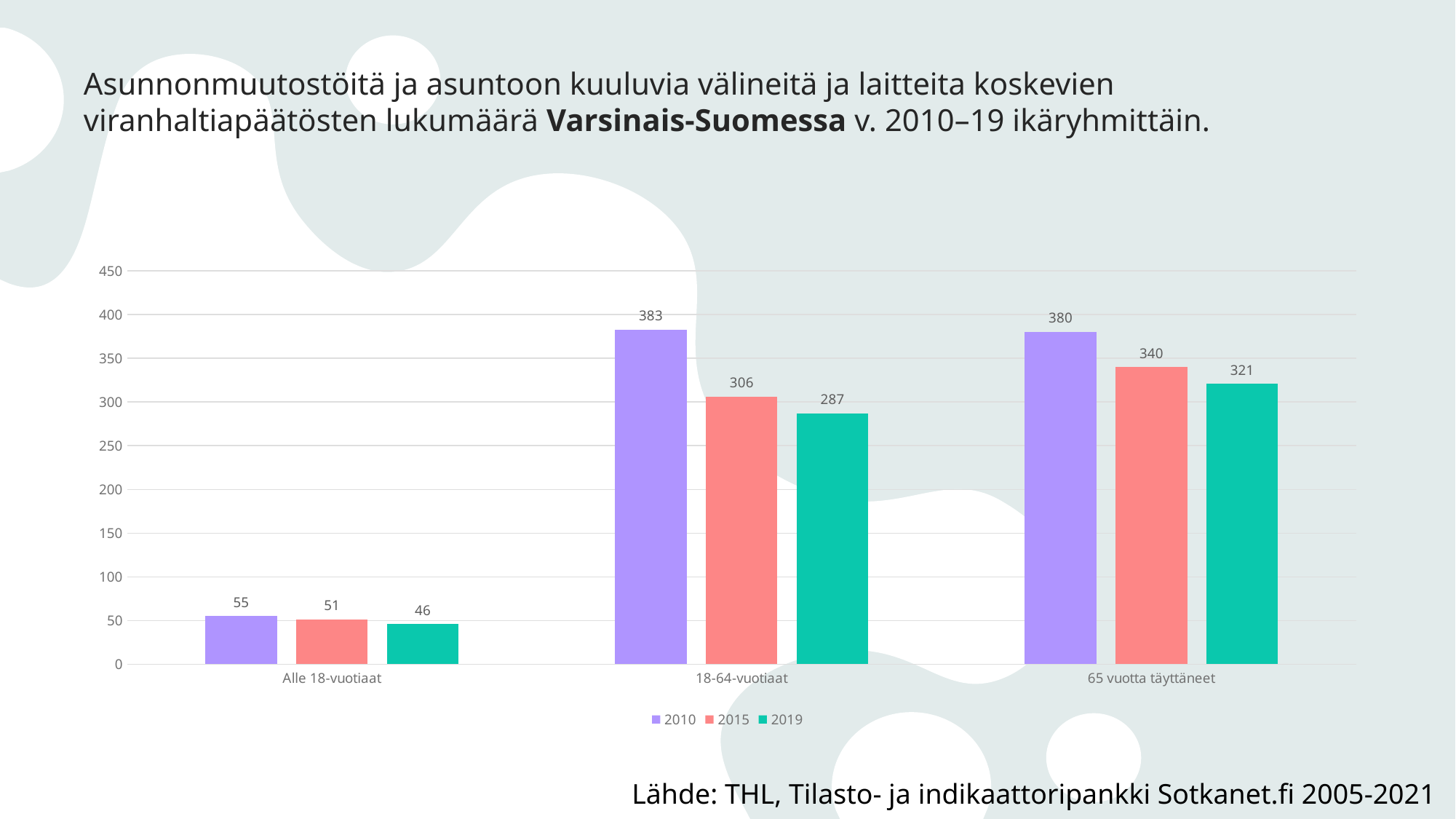
What is the value for 65 vuotta täyttäneet in 2019? 321 Is the 2019 value for 18-64-vuotiaat greater or less than 300? less What is the difference between the 2010 and 2019 values for 18-64-vuotiaat? 96 What is the value for Alle 18-vuotiaat in 2015? 51 Which age group has the lowest value in 2019? Alle 18-vuotiaat How many series does the legend list? 3 Which is larger: the 2015 value for 18-64-vuotiaat or the 2015 value for 65 vuotta täyttäneet? 65 vuotta täyttäneet What is the value for 18-64-vuotiaat in 2010? 383 Which age group has the highest value in 2015? 65 vuotta täyttäneet What kind of chart is shown on the slide? bar chart How many age groups are shown on the x axis? 3 Which years are listed in the legend? 2010, 2015, 2019